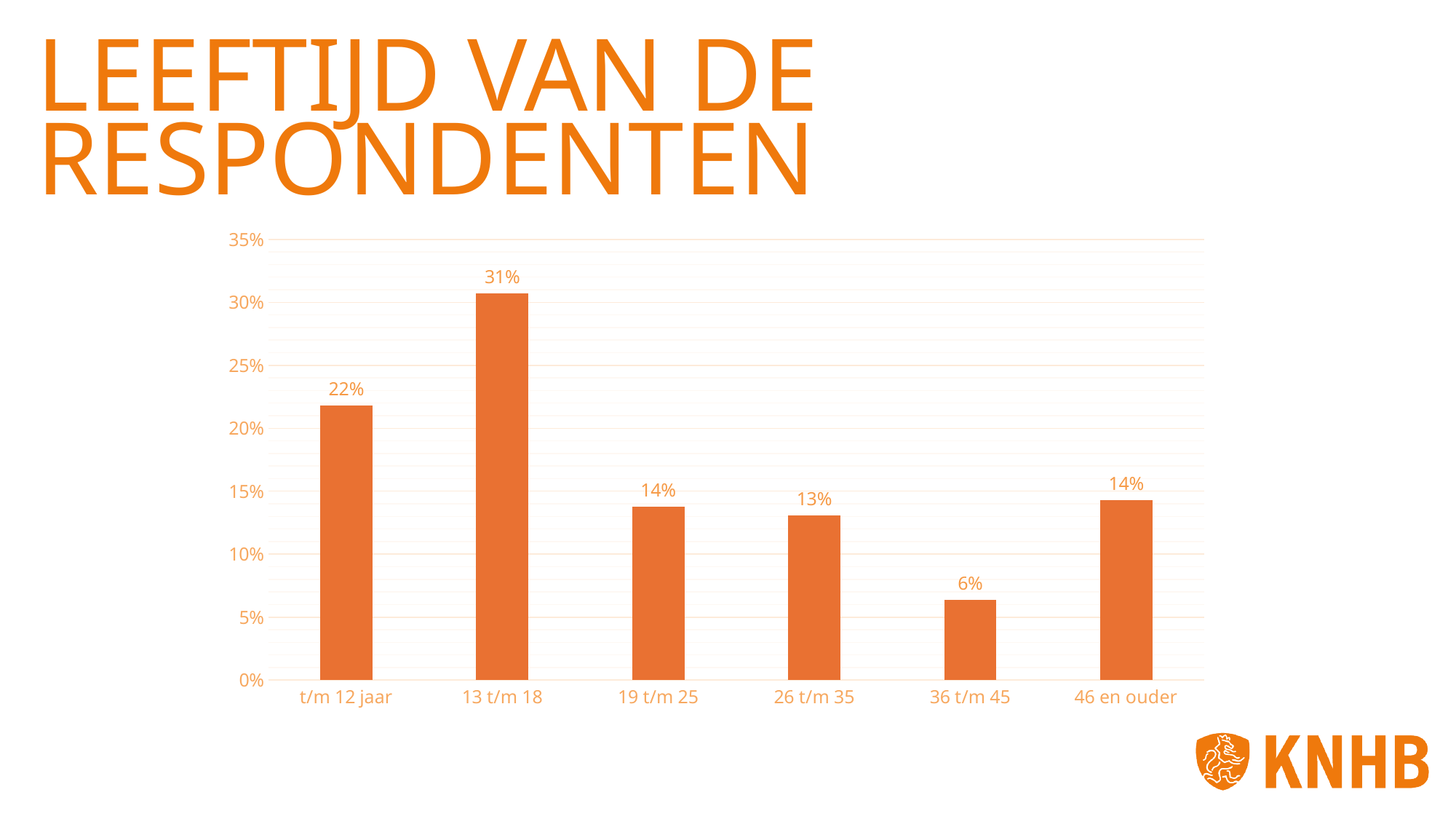
What percentage of respondents are in the 't/m 12 jaar' age group? 22% What kind of chart is shown on the slide? Bar chart Which age group has a larger share of respondents: 't/m 12 jaar' or '26 t/m 35'? t/m 12 jaar How many age groups are shown on the chart? 6 What is the title of the slide? LEEFTIJD VAN DE RESPONDENTEN Is the value for '13 t/m 18' greater or less than 30%? greater Which age group has the lowest share of respondents? 36 t/m 45 Which age group has the highest share of respondents? 13 t/m 18 What percentage of respondents are in the '26 t/m 35' age group? 13% What percentage of respondents are in the '13 t/m 18' age group? 31% What is the difference in percentage points between the '13 t/m 18' and 't/m 12 jaar' age groups? 9 What percentage of respondents are in the '36 t/m 45' age group? 6%